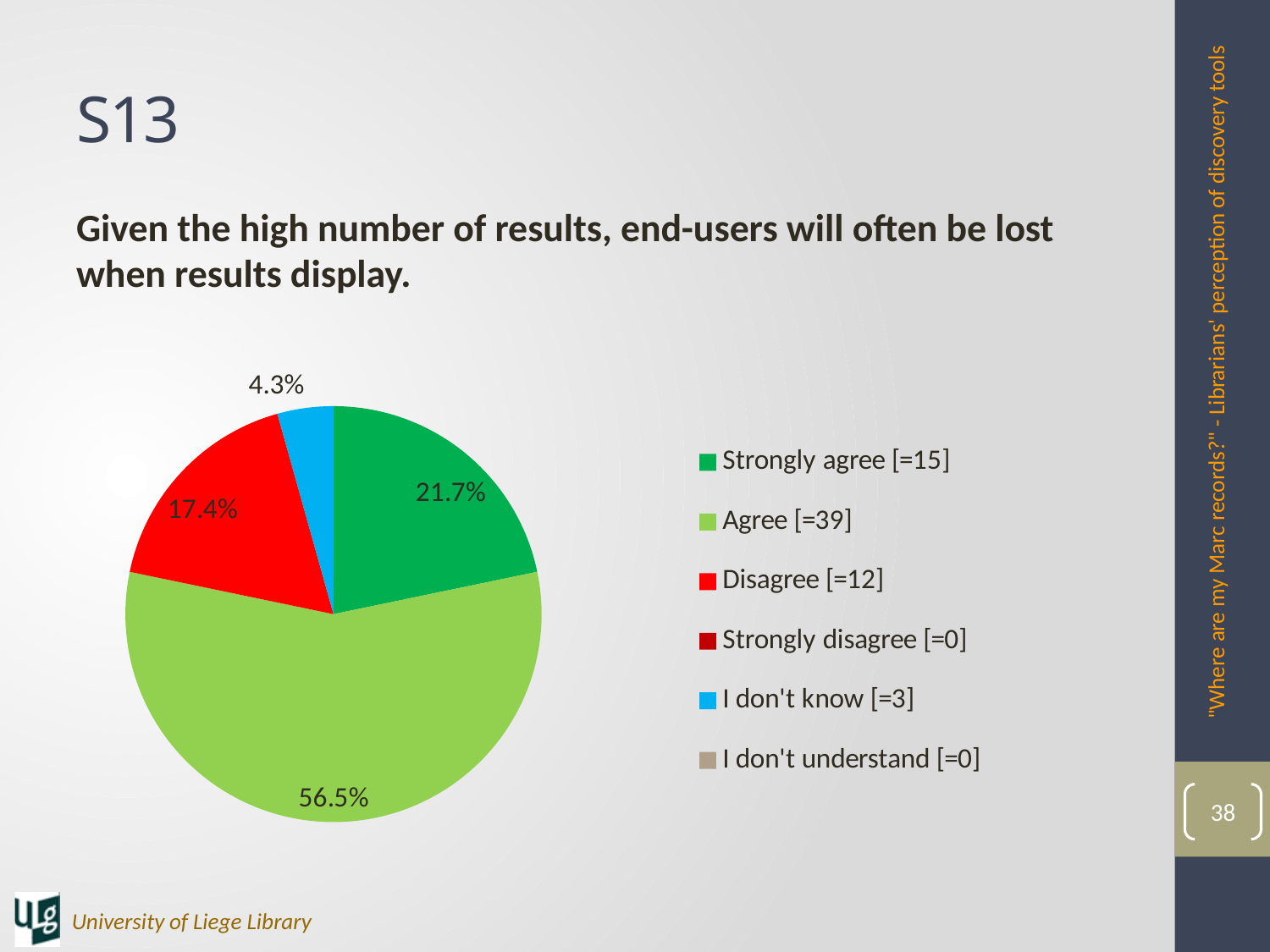
What percentage of the pie does the Strongly agree slice represent? 21.7% What percentage of the pie does the Disagree slice represent? 17.4% What percentage of the pie does the Agree slice represent? 56.5% Which category has the largest slice of the pie? Agree What is the difference in percentage points between the Agree slice and the Strongly agree slice? 34.8 How many respondents chose Agree according to the legend? 39 What colour is the Disagree slice of the pie? red How many entries does the legend list? 6 How many respondents chose Strongly disagree according to the legend? 0 What kind of chart is shown on the slide? pie chart Which of the two is larger: the Strongly agree slice or the Disagree slice? Strongly agree